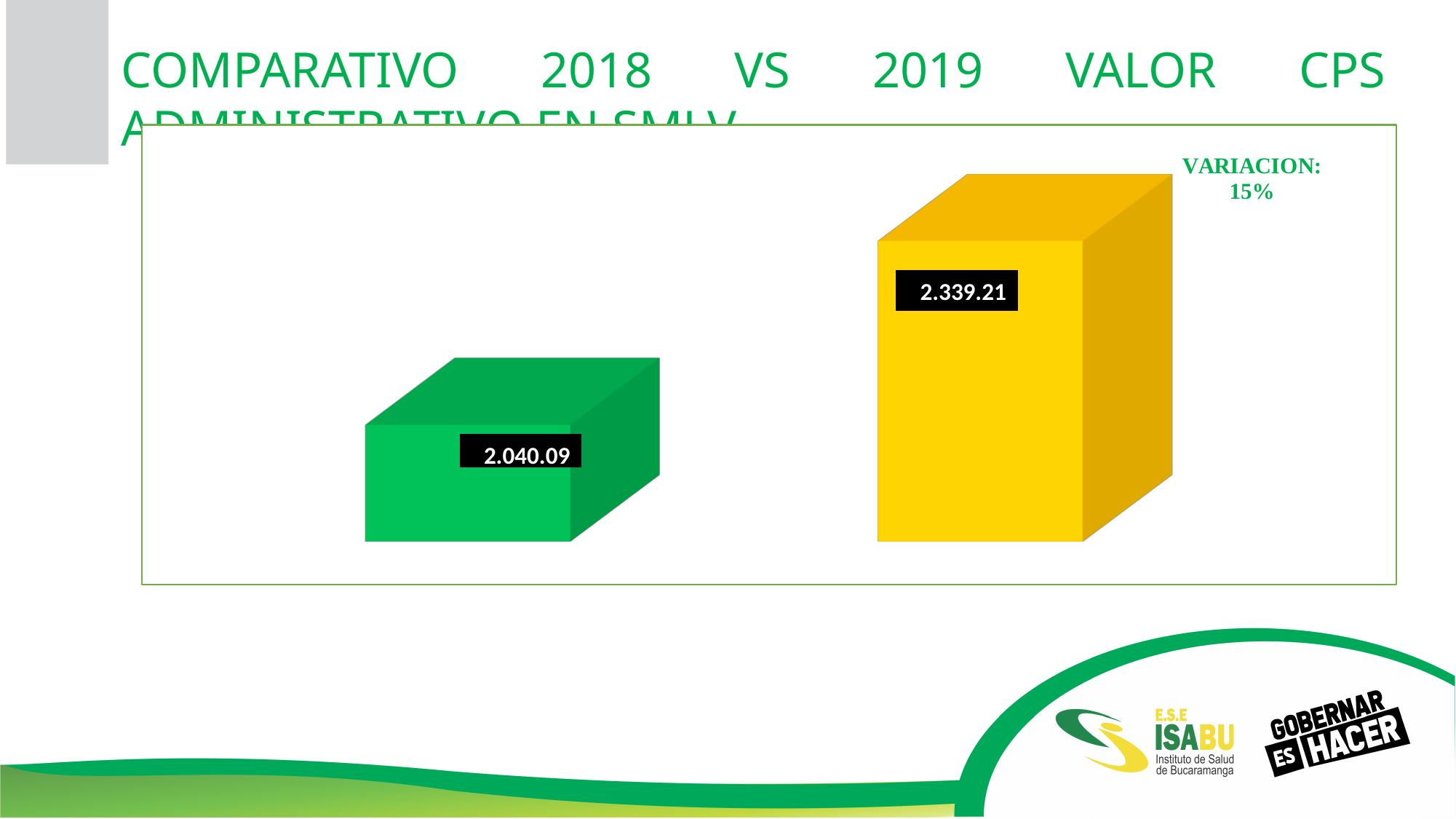
What kind of chart is shown on the slide? bar chart Which bar shows the lower value, the left one or the right one? the left one What variation percentage is printed in the top right corner of the chart? 15% What value is labelled on the green bar on the left? 2.040.09 What colour is the bar with the value 2.339.21? yellow Which bar shows the higher value, the green one or the yellow one? the yellow one How many bars are plotted in the chart? 2 Is the value on the yellow bar larger or smaller than the value on the green bar? larger What value is labelled on the yellow bar on the right? 2.339.21 What is the difference between the value on the yellow bar and the value on the green bar? 299.12 Do the bar values rise or fall from left to right? rise